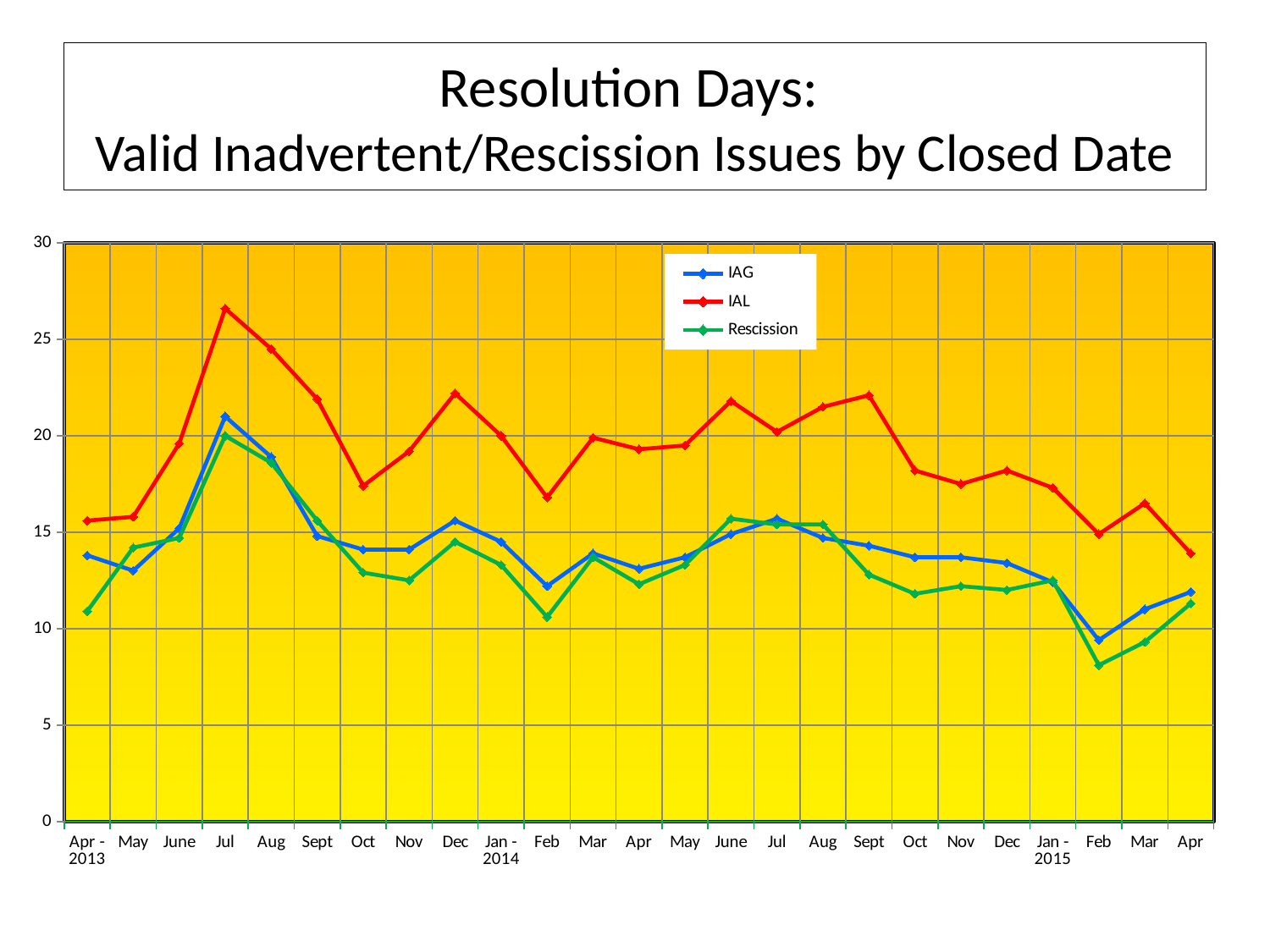
In which month does the IAG series reach its highest value? Jul (2013) Is the Rescission value for Feb 2015 greater or less than 10? less What kind of chart is shown on the slide? Line chart Is the IAL value for Jul 2013 greater or less than 25? greater What is the title of the chart? Resolution Days: Valid Inadvertent/Rescission Issues by Closed Date How many series does the legend list? 3 How many months (data points) are shown along the x axis? 25 Which series has the larger value in Apr 2013, IAG or Rescission? IAG In which month does the Rescission series reach its lowest value? Feb (2015) Is the IAL value for Sept 2014 greater or less than 20? greater Does the IAL series rise or fall from Jul 2013 to Oct 2013? Fall In which month does the IAL series reach its highest value? Jul (2013)